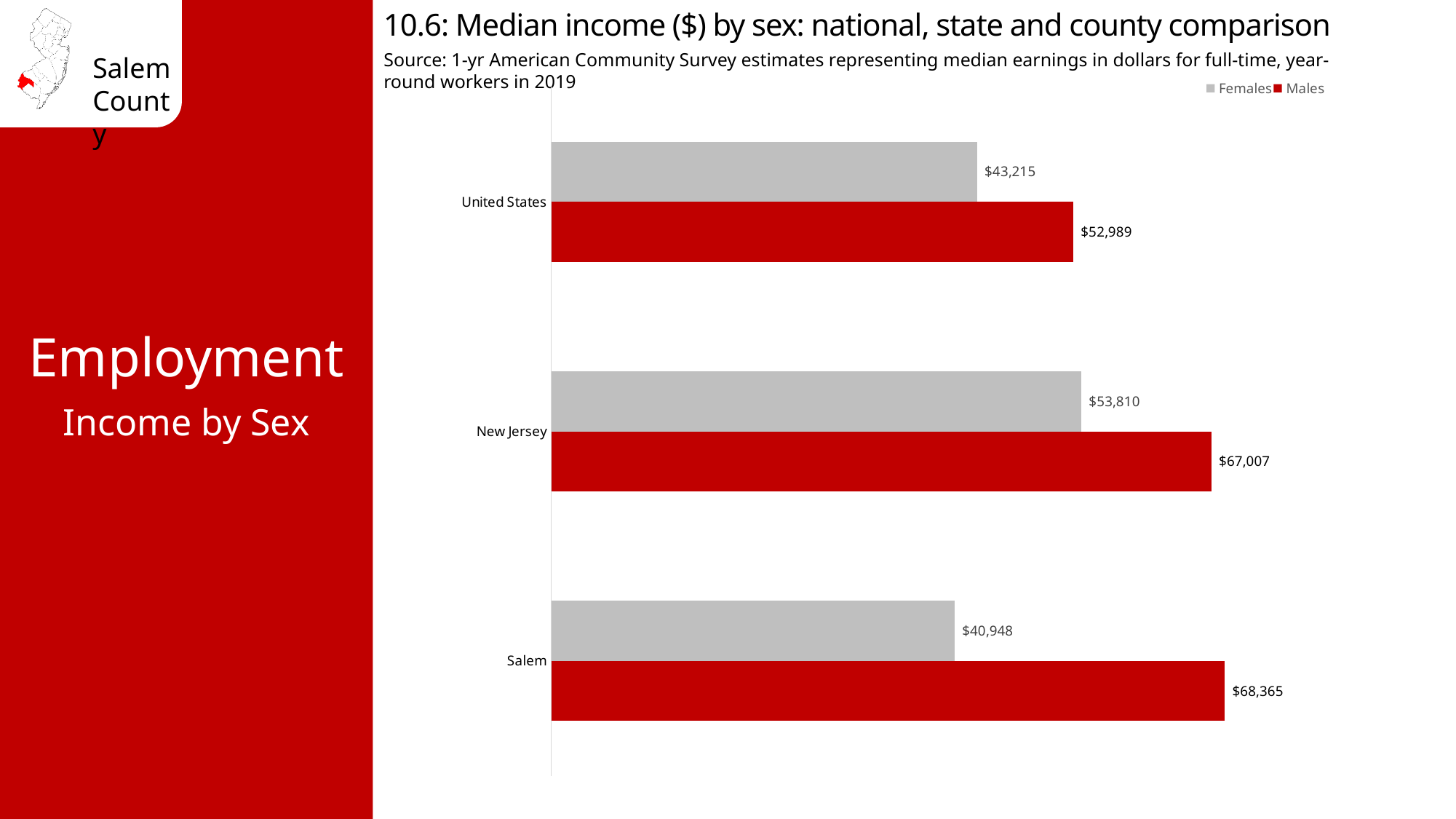
What kind of chart is shown on the slide? Bar chart What is the median income for Males in Salem? $68,365 How many categories are shown on the chart? 3 Which is larger: the Females median income in New Jersey or the Males median income in the United States? Females median income in New Jersey Which category has the lowest median income for Males? United States What is the difference between Males and Females median income in the United States? $9,774 What is the median income for Males in New Jersey? $67,007 What is the median income for Females in the United States? $43,215 How many series does the legend list? 2 What is the median income for Females in Salem? $40,948 Which category has the highest median income for Females? New Jersey What is the difference between Males and Females median income in Salem? $27,417